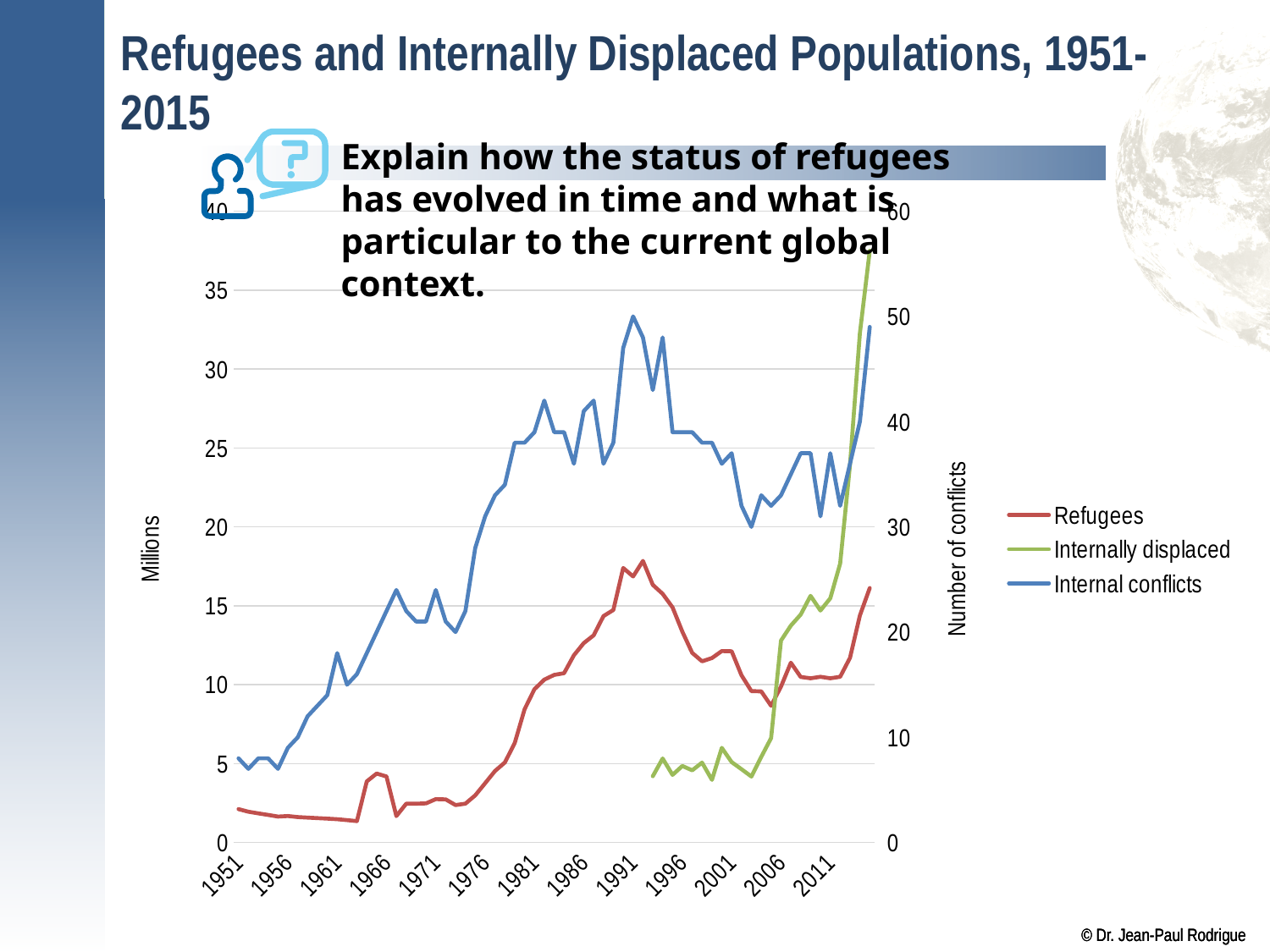
How many series does the legend list? 3 Is the value for Internal conflicts in 1951 greater or less than 10? less Is the value for Internally displaced at the end of the series (2015) greater or less than 35 million? greater Which series is drawn in green according to the legend? Internally displaced What is the title of the right-hand vertical axis? Number of conflicts In 2011, which is larger: Refugees or Internally displaced? Internally displaced How many year labels are shown along the x axis? 13 What kind of chart is shown on the slide? line chart Is the value for Refugees in 1991 greater or less than 15 million? greater Which series reaches the highest value on the Millions axis? Internally displaced Does the Internally displaced series rise or fall between 2006 and 2015? rise